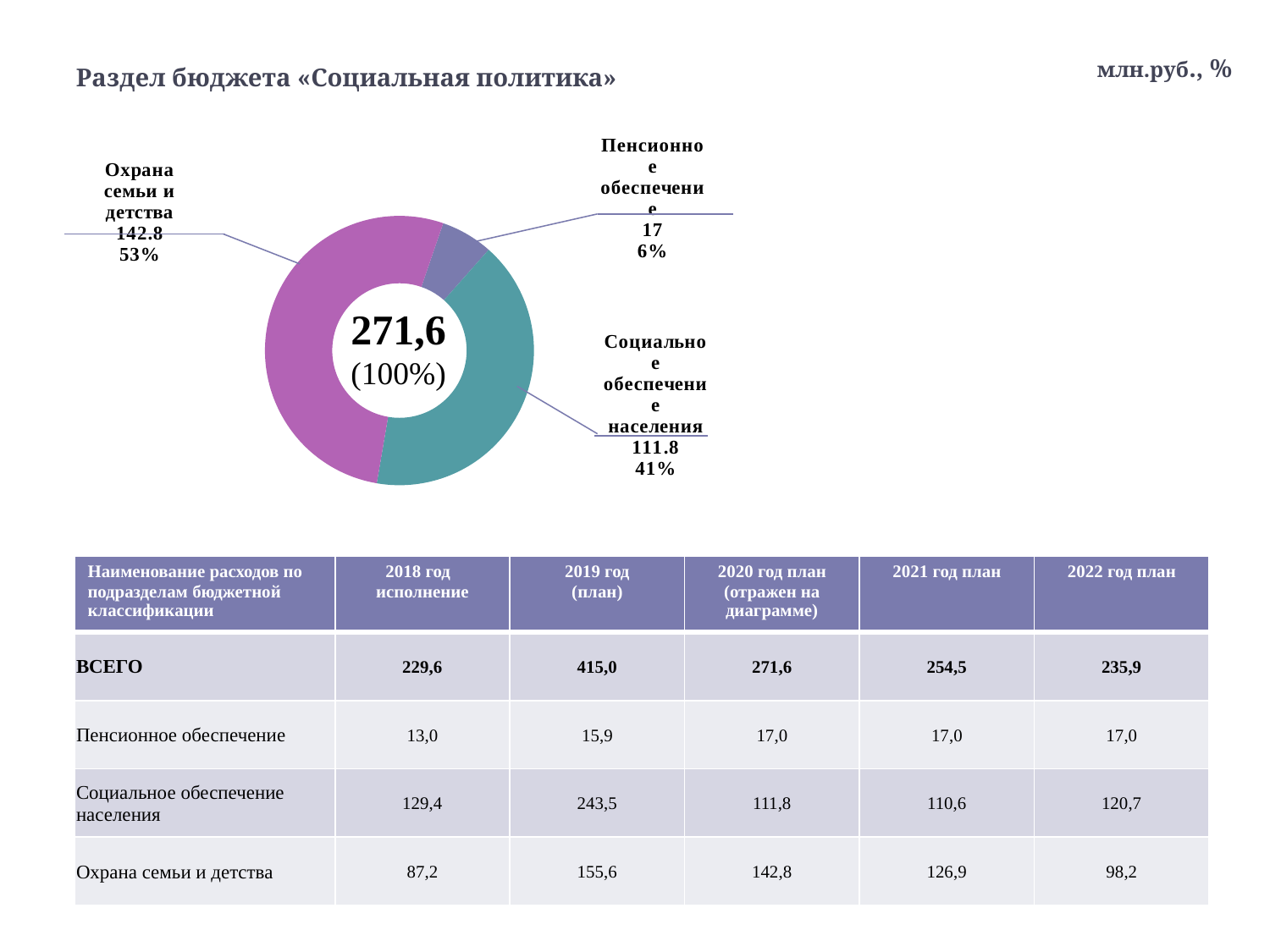
What share of the chart does «Пенсионное обеспечение» represent? 6% Which is larger on the chart: «Социальное обеспечение населения» or «Пенсионное обеспечение»? Социальное обеспечение населения What value is shown for «Охрана семьи и детства» on the chart? 142.8 What value is shown for «Социальное обеспечение населения» on the chart? 111.8 What share of the chart does «Социальное обеспечение населения» represent? 41% Which category has the smallest slice in the chart? Пенсионное обеспечение What share of the chart does «Охрана семьи и детства» represent? 53% What type of chart is shown on the slide? Pie (donut) chart Which category has the largest slice in the chart? Охрана семьи и детства What value is shown for «Пенсионное обеспечение» on the chart? 17 How many slices does the donut chart have? 3 What total value is shown in the centre of the donut chart? 271,6